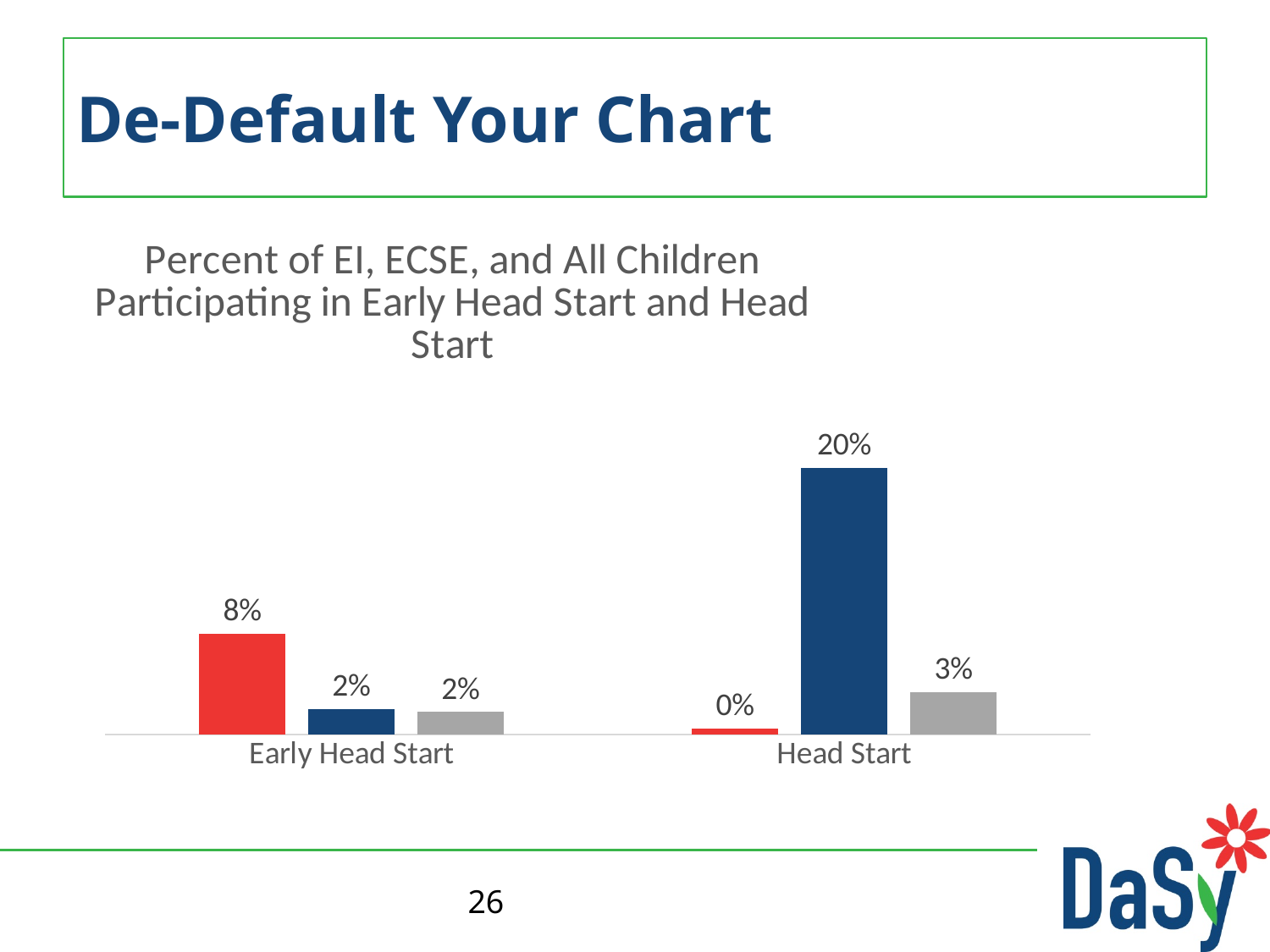
Which bar has the lowest value in the chart? The red bar for Head Start (0%) What is the value of the red bar for Head Start? 0% How many categories are shown on the x axis? 2 What is the difference between the blue bar for Head Start and the blue bar for Early Head Start? 18% What is the difference between the red bar and the gray bar for Early Head Start? 6% Which category has the tallest bar in the chart? Head Start What is the value of the red bar for Early Head Start? 8% What is the value of the blue bar for Early Head Start? 2% What type of chart is shown on the slide? Bar chart What is the value of the gray bar for Head Start? 3% What is the value of the blue bar for Head Start? 20% Which is larger: the red bar for Early Head Start or the gray bar for Head Start? The red bar for Early Head Start